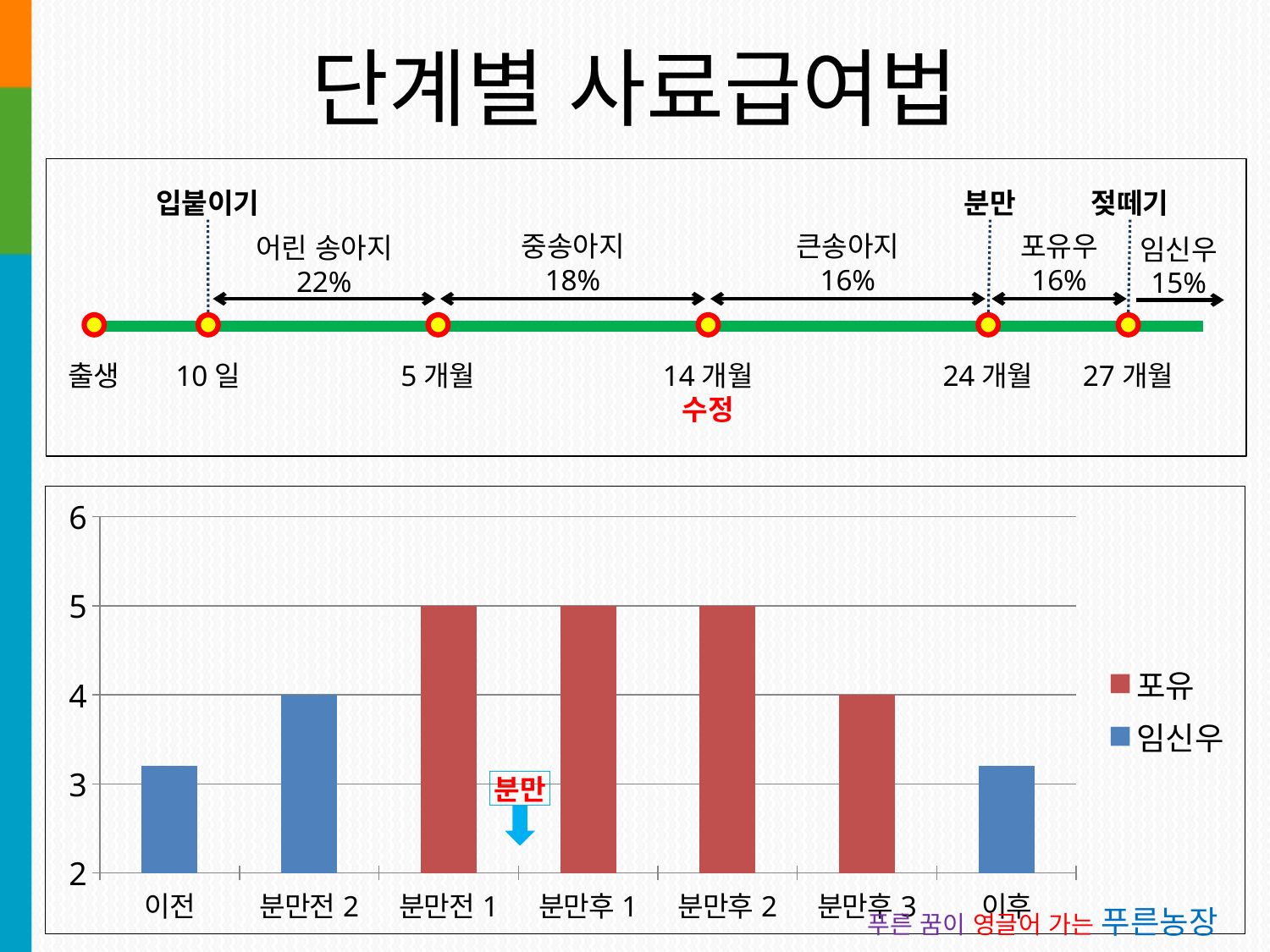
In the bar chart, what is the value for 분만전 1? 5 In the bar chart, what is the value for 분만후 3? 4 In the bar chart, what is the value for 분만전 2? 4 In the bar chart, is the value for 이전 greater or less than 3? greater In the bar chart, is the value for 이후 greater or less than 4? less What are the two legend entries in the bar chart? 포유, 임신우 What kind of chart is shown at the bottom of the slide? bar chart How many series does the legend of the bar chart list? 2 In the bar chart, which series is drawn in red? 포유 How many categories are shown on the x axis of the bar chart? 7 In the bar chart, what is the difference between the value for 분만후 1 and the value for 분만후 3? 1 In the bar chart, which is larger, the value for 분만전 2 or the value for 분만전 1? 분만전 1